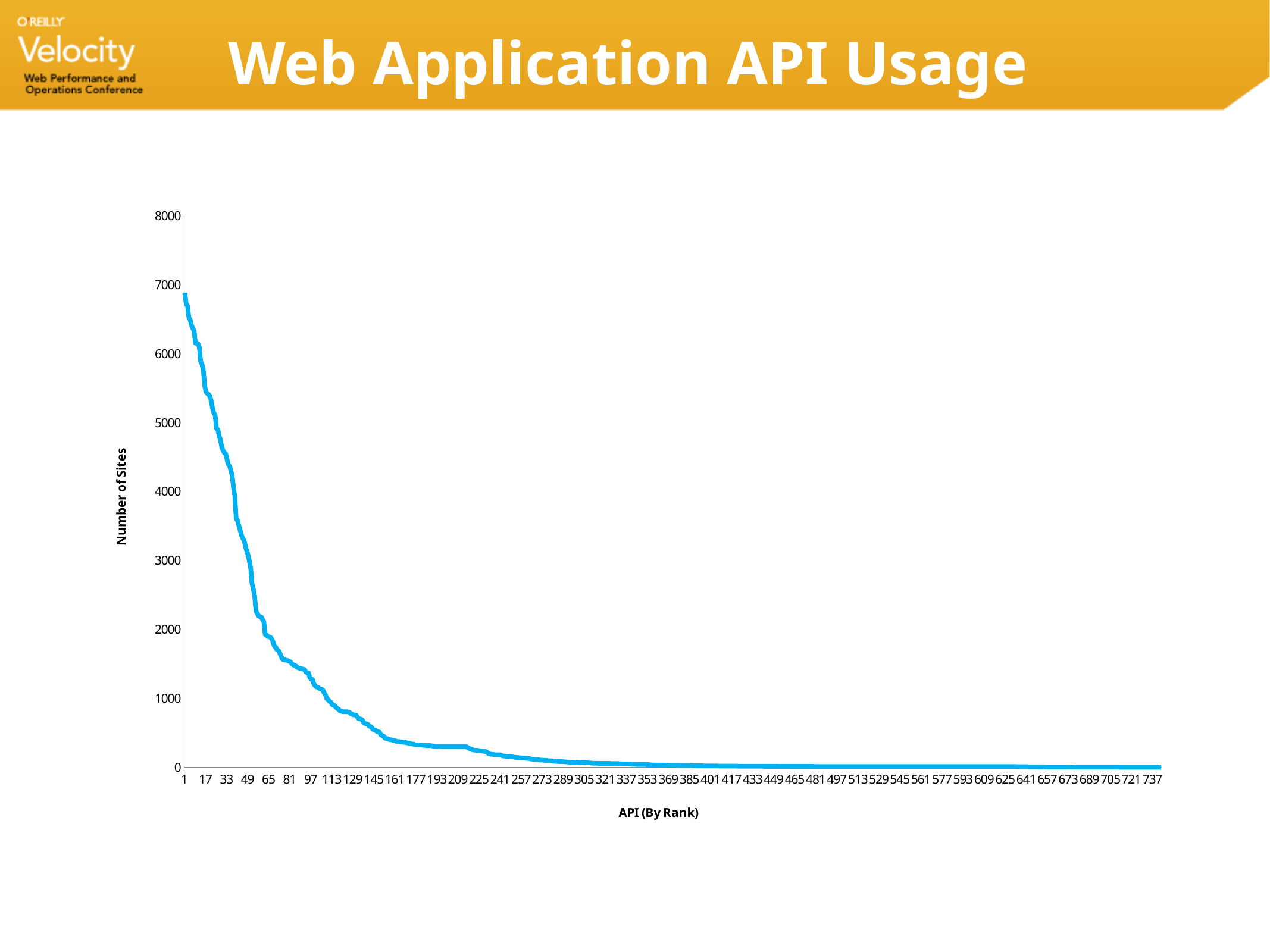
Is the number of sites for API rank 17 greater or less than 5000? greater Do the values rise or fall as the API rank increases along the x axis? fall What is the title of the vertical axis? Number of Sites Is the number of sites for API rank 81 greater or less than 2000? less Which API rank has the highest number of sites? 1 What is the title of the horizontal axis? API (By Rank) Is the number of sites for API rank 1 greater or less than 7000? less What kind of chart is shown on the slide? line chart Which has more sites, API rank 33 or API rank 97? API rank 33